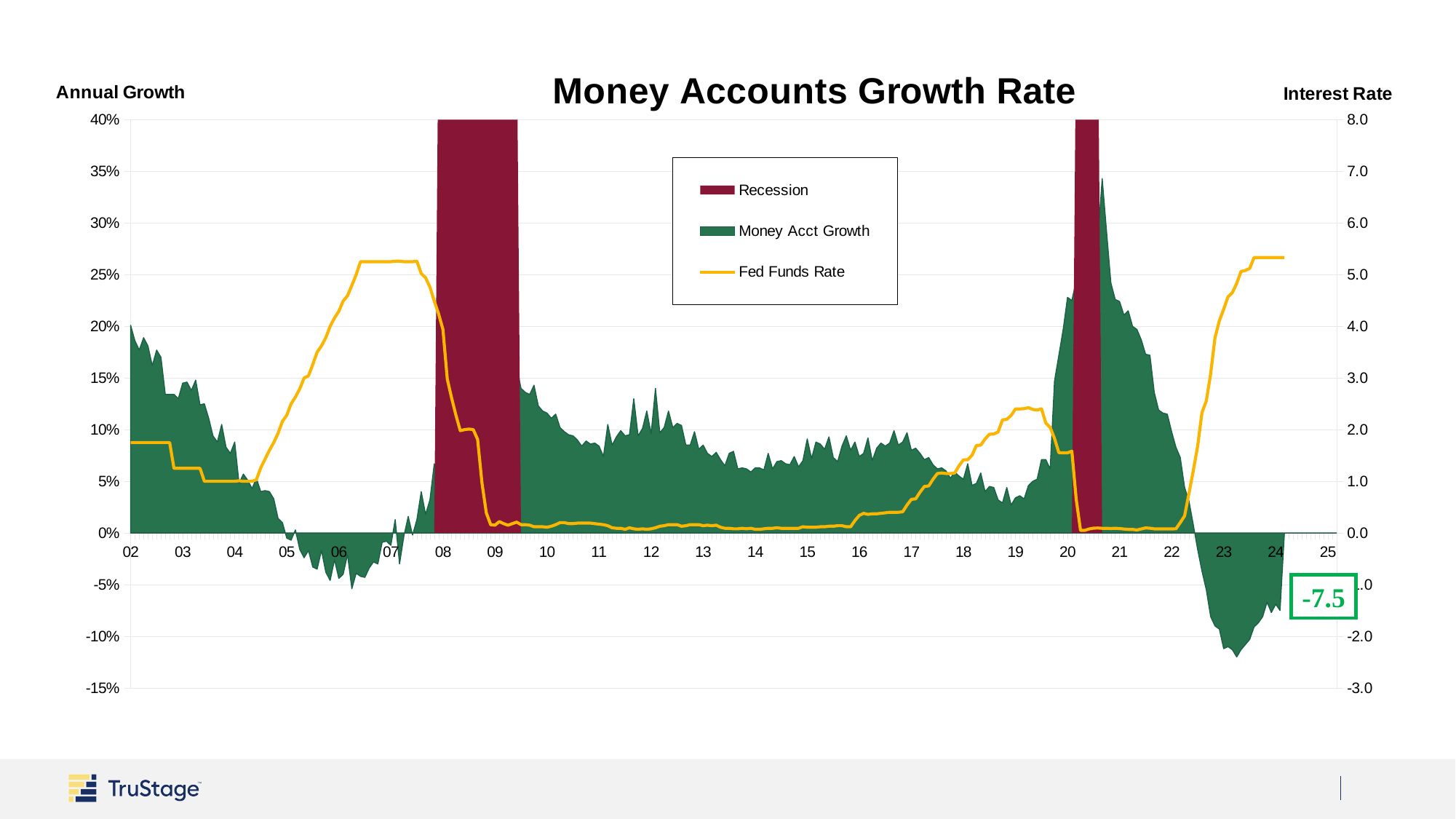
Which is higher, Money Acct Growth in 2002 or in 2012? 2002 What is the title of the chart? Money Accounts Growth Rate Is the Fed Funds Rate in 2007 greater or less than 4.0? greater What is the most recent value labeled on the chart for Money Acct Growth? -7.5 What is the label of the right-hand axis? Interest Rate How many series does the legend list? 3 Is the Fed Funds Rate in 2012 greater or less than 1.0? less What kind of chart is used to show Money Acct Growth? Area chart How many recession periods are shaded on the chart? 2 In which year does Money Acct Growth reach its lowest point? 2023 Is the peak of Money Acct Growth around 2020-21 greater or less than 30%? greater Does the Fed Funds Rate rise or fall between 2022 and 2024? rise